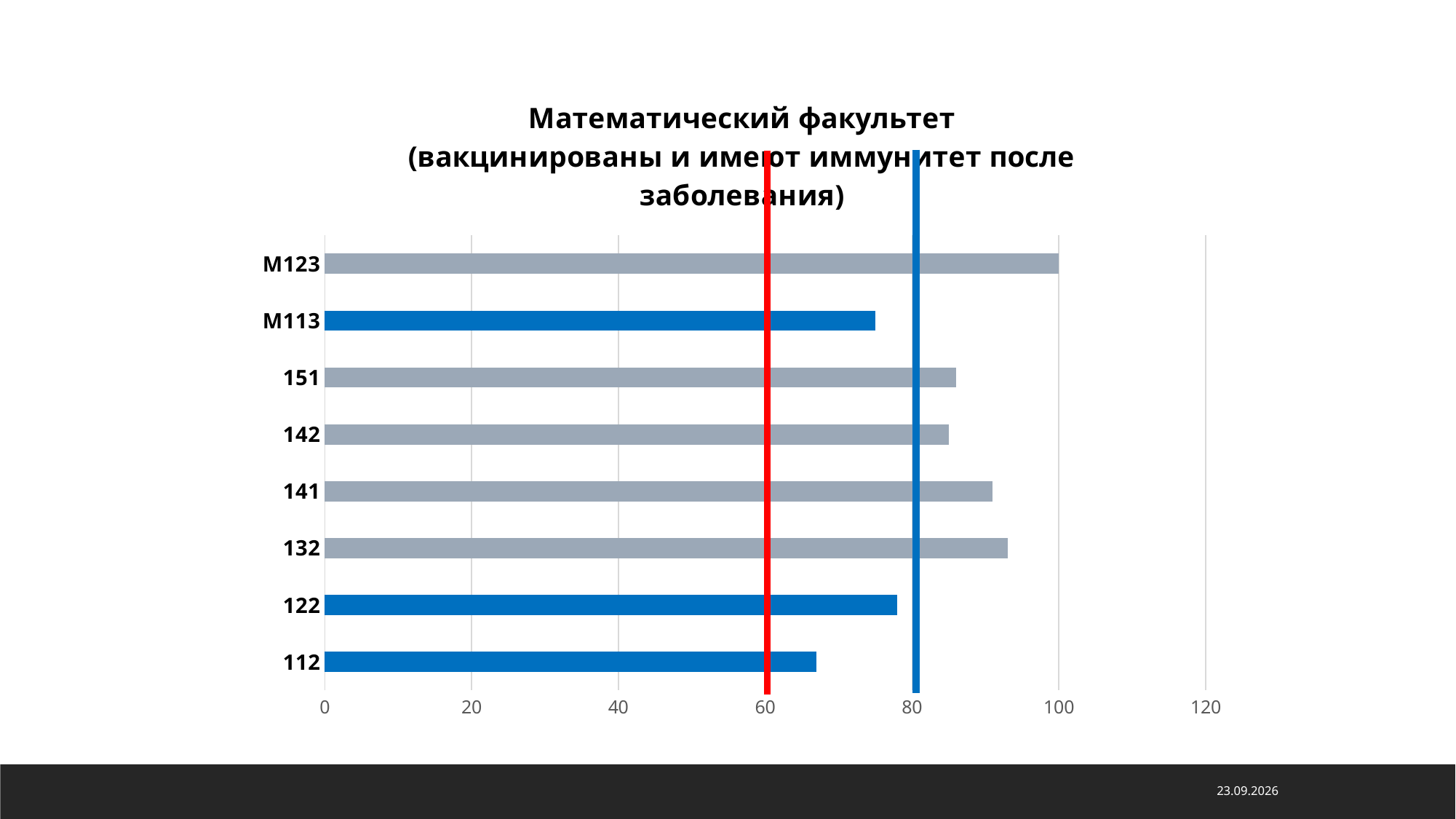
Is the value for 112 greater or less than 60? greater Which is larger, the value for 141 or the value for 122? 141 What is the first line of the chart title? Математический факультет How many categories (groups) are plotted in the chart? 8 Which category has the highest value in the chart? М123 What kind of chart is shown on the slide? bar chart Is the value for 132 greater or less than 100? less Is the value for 141 greater or less than 80? greater Which category has the lowest value in the chart? 112 Which is larger, the value for 132 or the value for 112? 132 What is the value for М123? 100